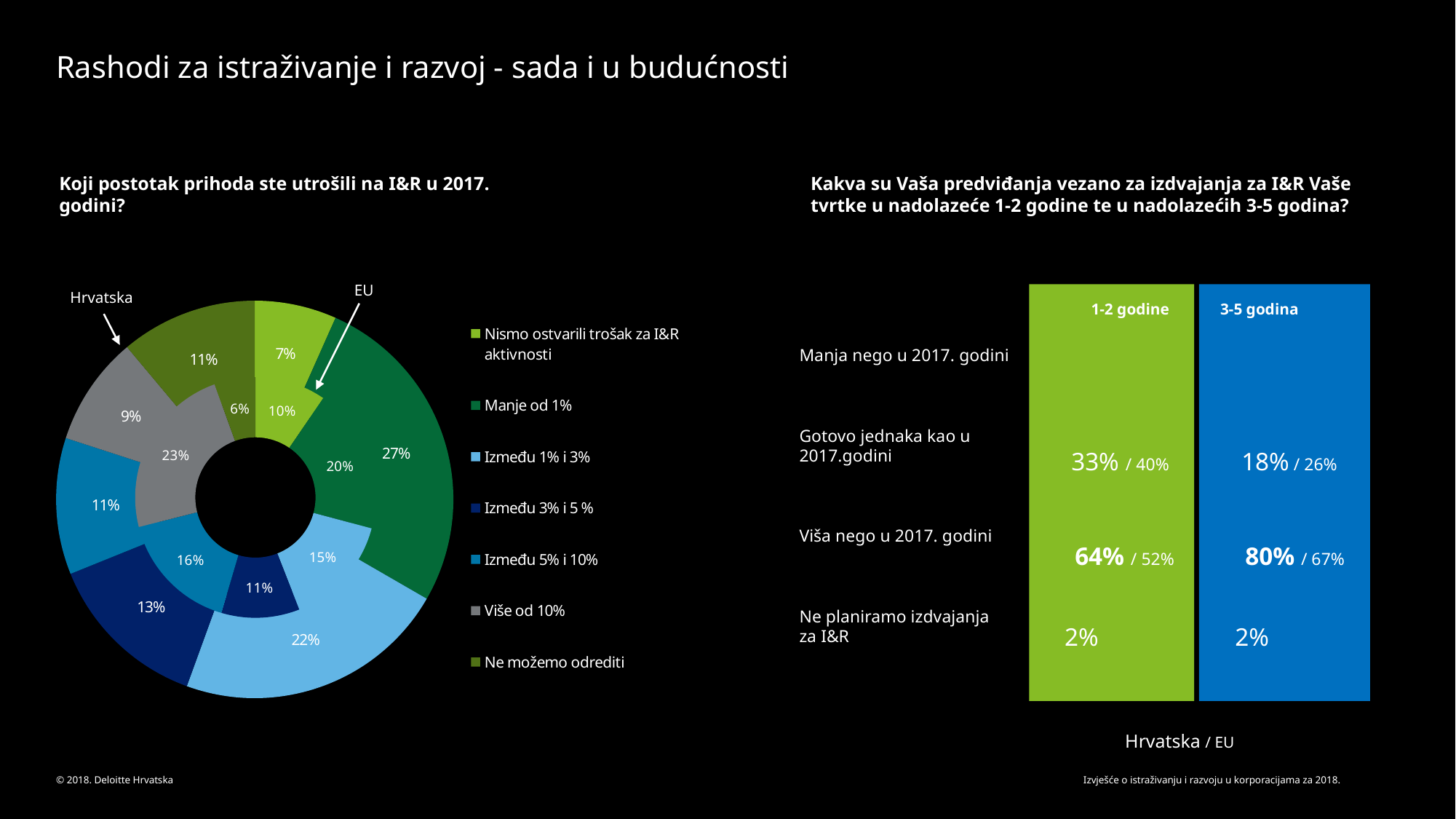
In the doughnut chart on the left, how many categories does the legend list? 7 In the doughnut chart on the left, which category has the lowest Hrvatska value? Nismo ostvarili trošak za I&R aktivnosti What kind of chart is shown on the left side of the slide? Doughnut chart In the doughnut chart on the left, what is the Hrvatska value for 'Više od 10%'? 9% In the graphic on the right, what is the Hrvatska value for 'Viša nego u 2017. godini' in the 3-5 godina column? 80% In the graphic on the right, what is the EU value for 'Gotovo jednaka kao u 2017.godini' in the 1-2 godine column? 40% In the doughnut chart on the left, which ring represents Hrvatska, the inner or the outer ring? Outer ring In the doughnut chart on the left, which category has the highest EU value? Više od 10% In the doughnut chart on the left, which is larger for 'Više od 10%': the Hrvatska value or the EU value? EU In the doughnut chart on the left, what is the EU value for 'Manje od 1%'? 20% In the doughnut chart on the left, what is the Hrvatska value for 'Nismo ostvarili trošak za I&R aktivnosti'? 7% In the doughnut chart on the left, what is the difference between the EU and Hrvatska values for 'Između 1% i 3%'? 7%